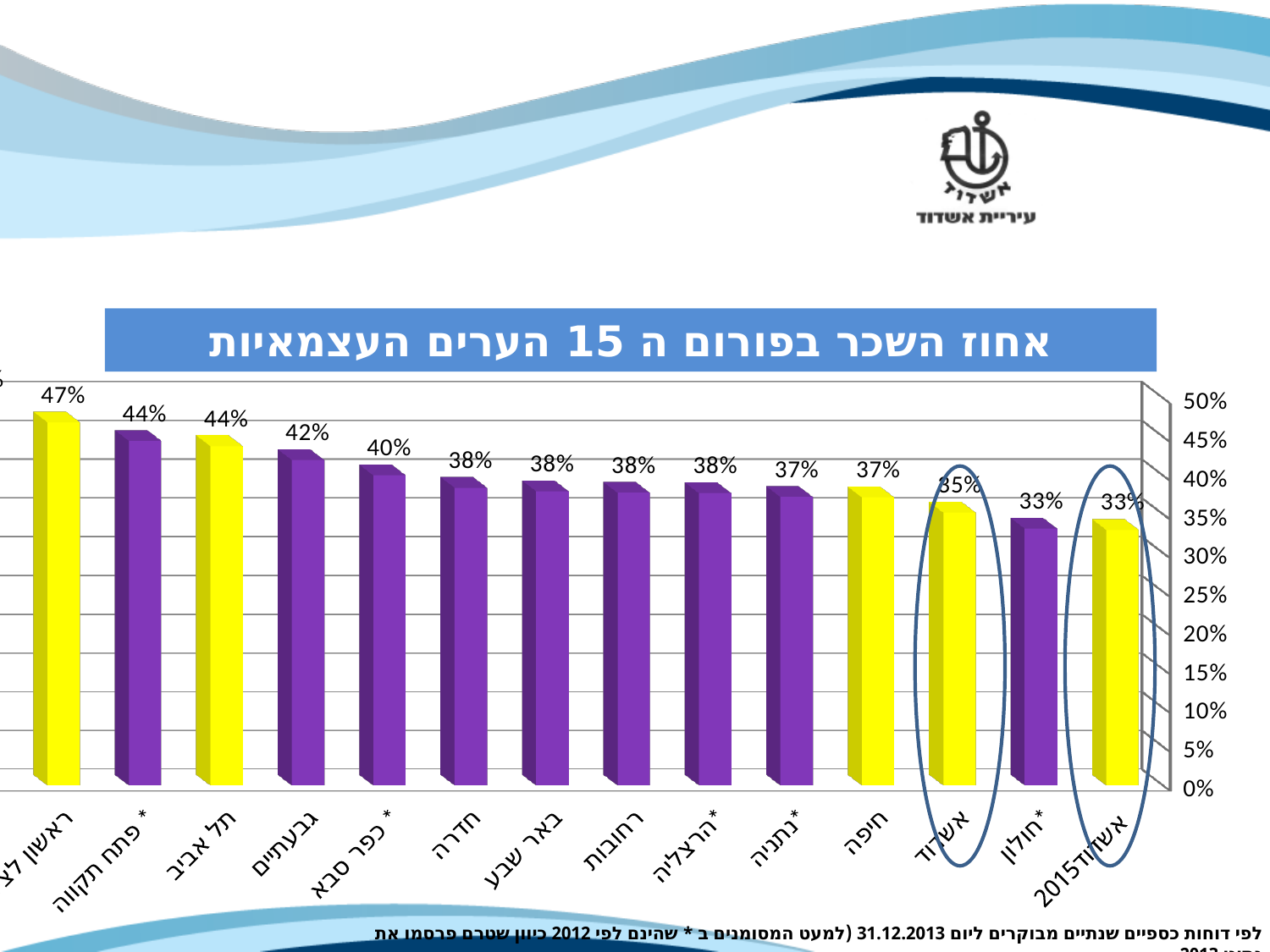
What is the value for חיפה? 37% What is the difference between the values for תל אביב and אשדוד? 9% What is the value for חולון? 33% Is the value for חדרה greater or less than 35%? greater What kind of chart is shown on the slide? bar chart What is the value for גבעתיים? 42% What is the value for אשדוד in the chart? 35% Do the values generally rise or fall from left to right along the x axis? fall What is the value for כפר סבא? 40% What is the title of the chart? אחוז השכר בפורום ה 15 הערים העצמאיות Which is larger, the value for גבעתיים or the value for נתניה? גבעתיים What is the value for אשדוד 2015? 33%